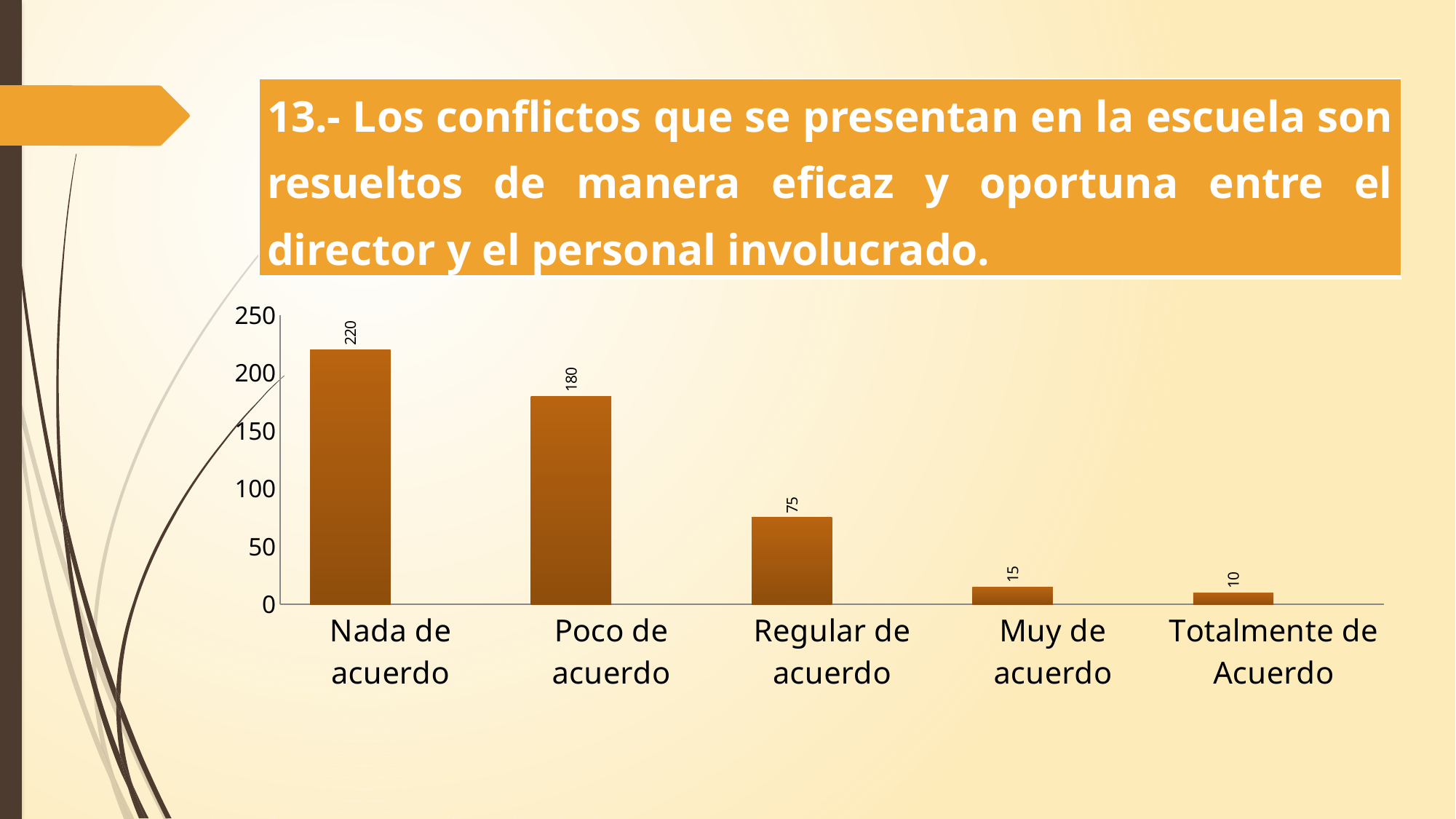
What is the value for "Totalmente de Acuerdo"? 10 Do the values rise or fall from left to right along the x axis? Fall How many categories are shown on the x axis? 5 Which category has the lowest value? Totalmente de Acuerdo Is the value for "Poco de acuerdo" greater or less than 150? greater Which is larger, the value for "Muy de acuerdo" or the value for "Regular de acuerdo"? Regular de acuerdo What is the value for "Regular de acuerdo"? 75 What is the value for "Nada de acuerdo"? 220 Which category has the highest value? Nada de acuerdo What kind of chart is shown on the slide? Bar chart What is the difference between the values for "Nada de acuerdo" and "Poco de acuerdo"? 40 What is the value for "Poco de acuerdo"? 180